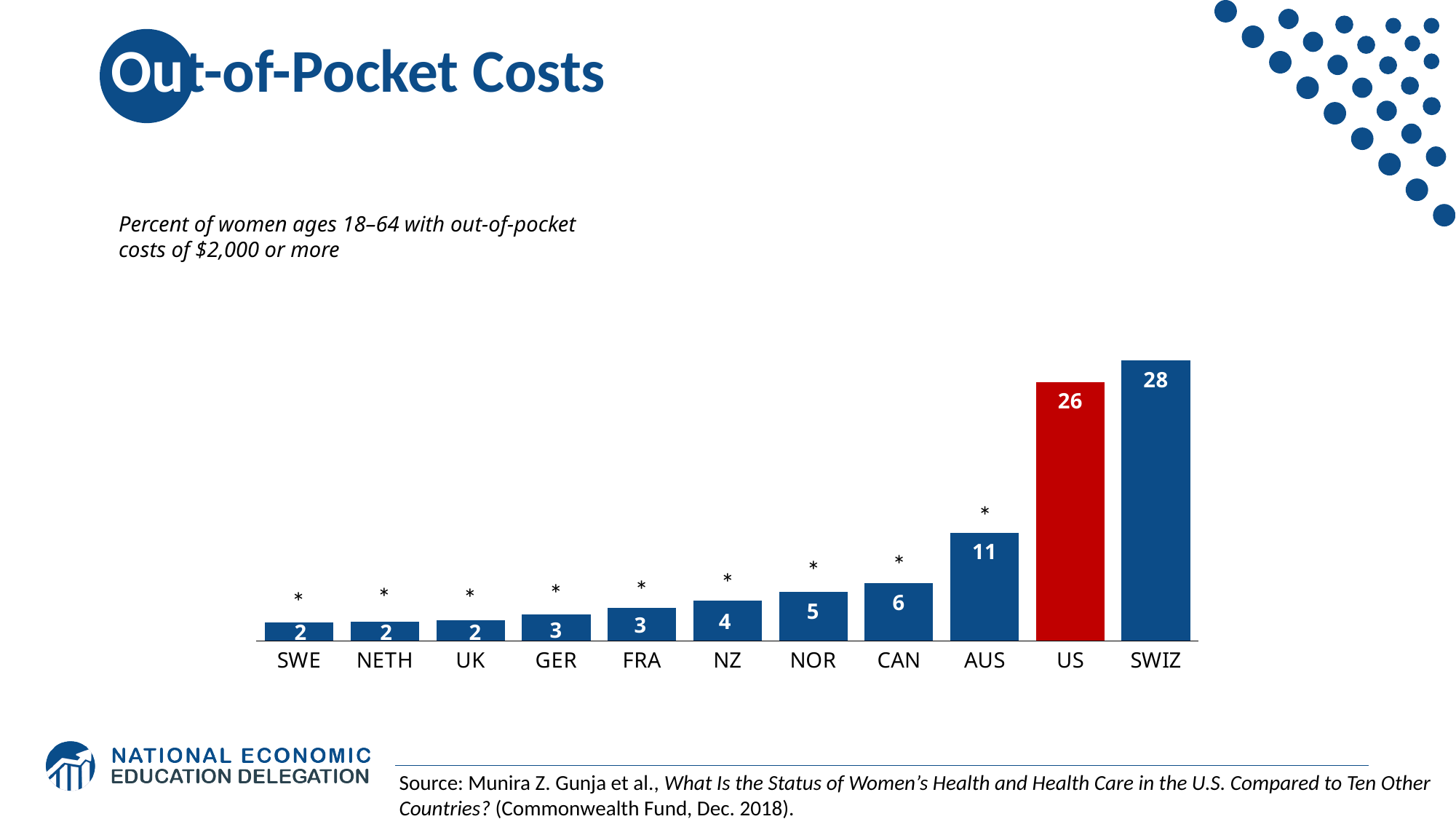
Which bar is coloured red rather than blue? US What is the value for AUS? 11 What kind of chart is shown on the slide? Bar chart What is the title of the slide? Out-of-Pocket Costs What is the value for the US? 26 What is the difference between the values for the US and AUS? 15 Do the values rise or fall from left to right along the x axis? Rise Which country has the highest value? SWIZ What is the difference between the values for SWIZ and the US? 2 Which has a larger value, CAN or NZ? CAN What is the value for NOR? 5 How many countries are shown on the chart? 11